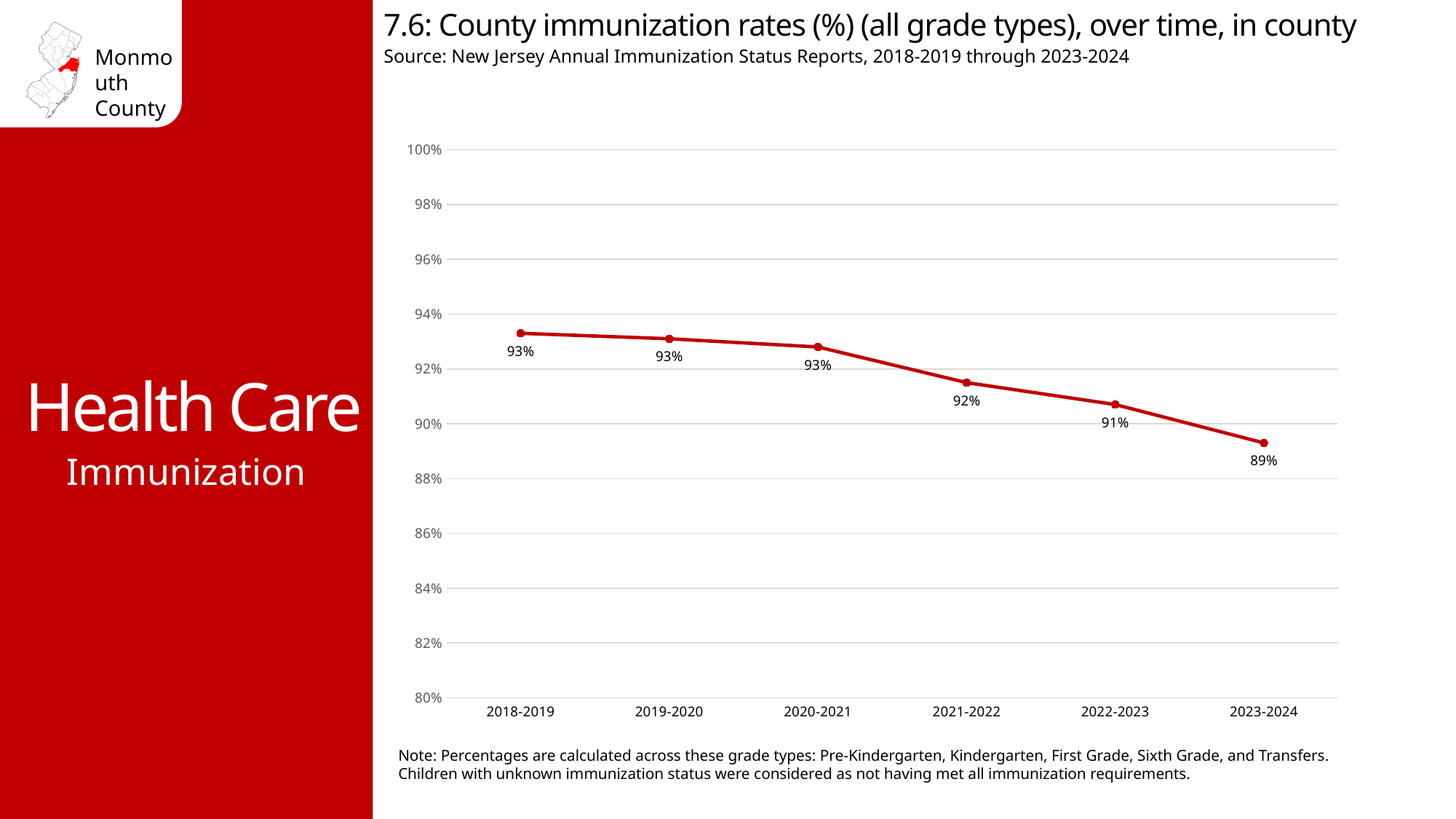
How many school years are plotted on the chart? 6 What is the county immunization rate for 2018-2019? 93% Is the value for 2018-2019 greater or less than 92%? greater Which is larger, the immunization rate for 2021-2022 or for 2023-2024? 2021-2022 What is the county immunization rate for 2021-2022? 92% What is the county immunization rate for 2023-2024? 89% What is the county immunization rate for 2022-2023? 91% Is the value for 2023-2024 greater or less than 90%? less Which school year has the lowest immunization rate? 2023-2024 What kind of chart is shown on the slide? line chart What is the difference between the immunization rate in 2018-2019 and in 2023-2024? 4% Do the immunization rates rise or fall from 2018-2019 to 2023-2024? fall